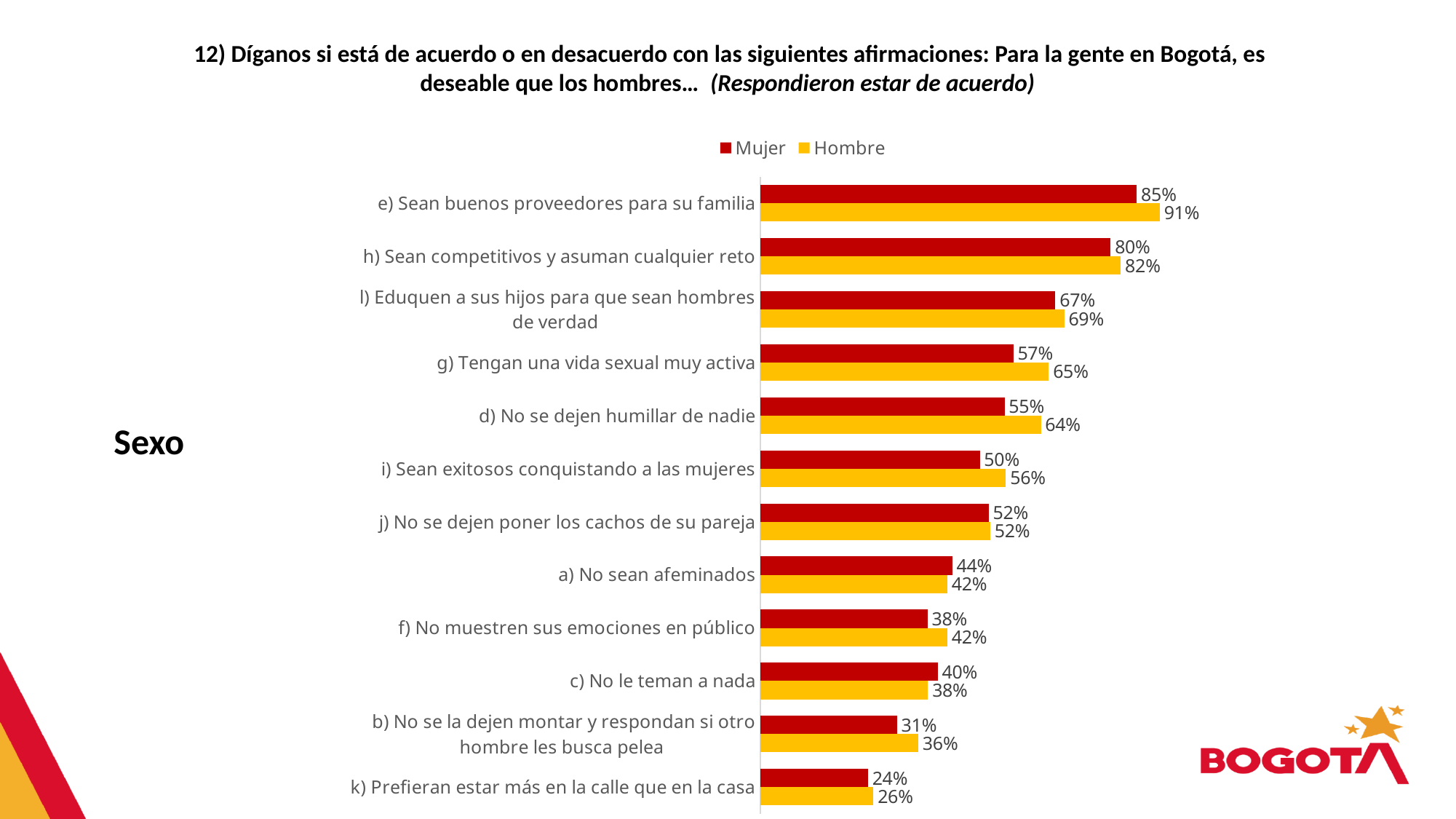
How many series does the legend list? 2 What is the Hombre value for "b) No se la dejen montar y respondan si otro hombre les busca pelea"? 36% For "f) No muestren sus emociones en público", which is larger, the Mujer value or the Hombre value? Hombre Which category has the lowest Mujer value? k) Prefieran estar más en la calle que en la casa Which series is shown in red in the legend? Mujer How many categories (statements) are shown in the chart? 12 What kind of chart is shown on the slide? Bar chart What is the Mujer value for "e) Sean buenos proveedores para su familia"? 85% Which category has the highest Hombre value? e) Sean buenos proveedores para su familia What is the Hombre value for "g) Tengan una vida sexual muy activa"? 65% What is the difference between the Hombre and Mujer values for "d) No se dejen humillar de nadie"? 9% For "a) No sean afeminados", which is larger, the Mujer value or the Hombre value? Mujer